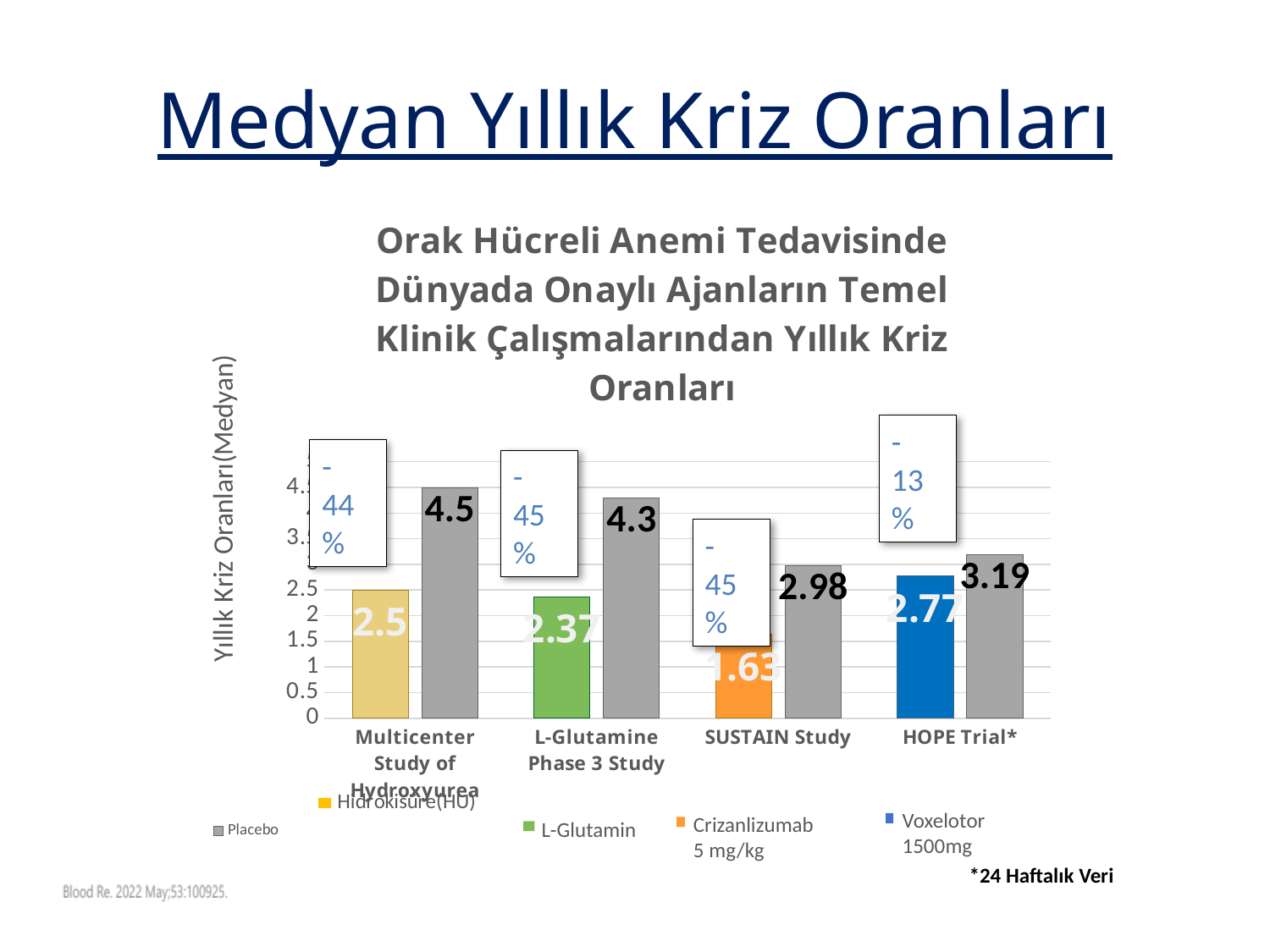
What is the difference between the placebo value and the L-Glutamin value in the L-Glutamine Phase 3 Study? 1.93 What is the difference between the placebo value and the Voxelotor 1500mg value in the HOPE Trial*? 0.42 What is the value for Crizanlizumab 5 mg/kg in the SUSTAIN Study? 1.63 Which is larger: the placebo value in the SUSTAIN Study or the placebo value in the HOPE Trial*? HOPE Trial* What percentage reduction is shown for the HOPE Trial*? -13% How many studies are shown on the x axis of the chart? 4 Which treatment bar has the lowest value on the chart? Crizanlizumab 5 mg/kg (1.63) What is the placebo value in the L-Glutamine Phase 3 Study? 4.3 What is the value for Voxelotor 1500mg in the HOPE Trial*? 2.77 Which study has the highest placebo value? Multicenter Study of Hydroxyurea What is the placebo value for the Multicenter Study of Hydroxyurea? 4.5 How many series does the legend list? 5